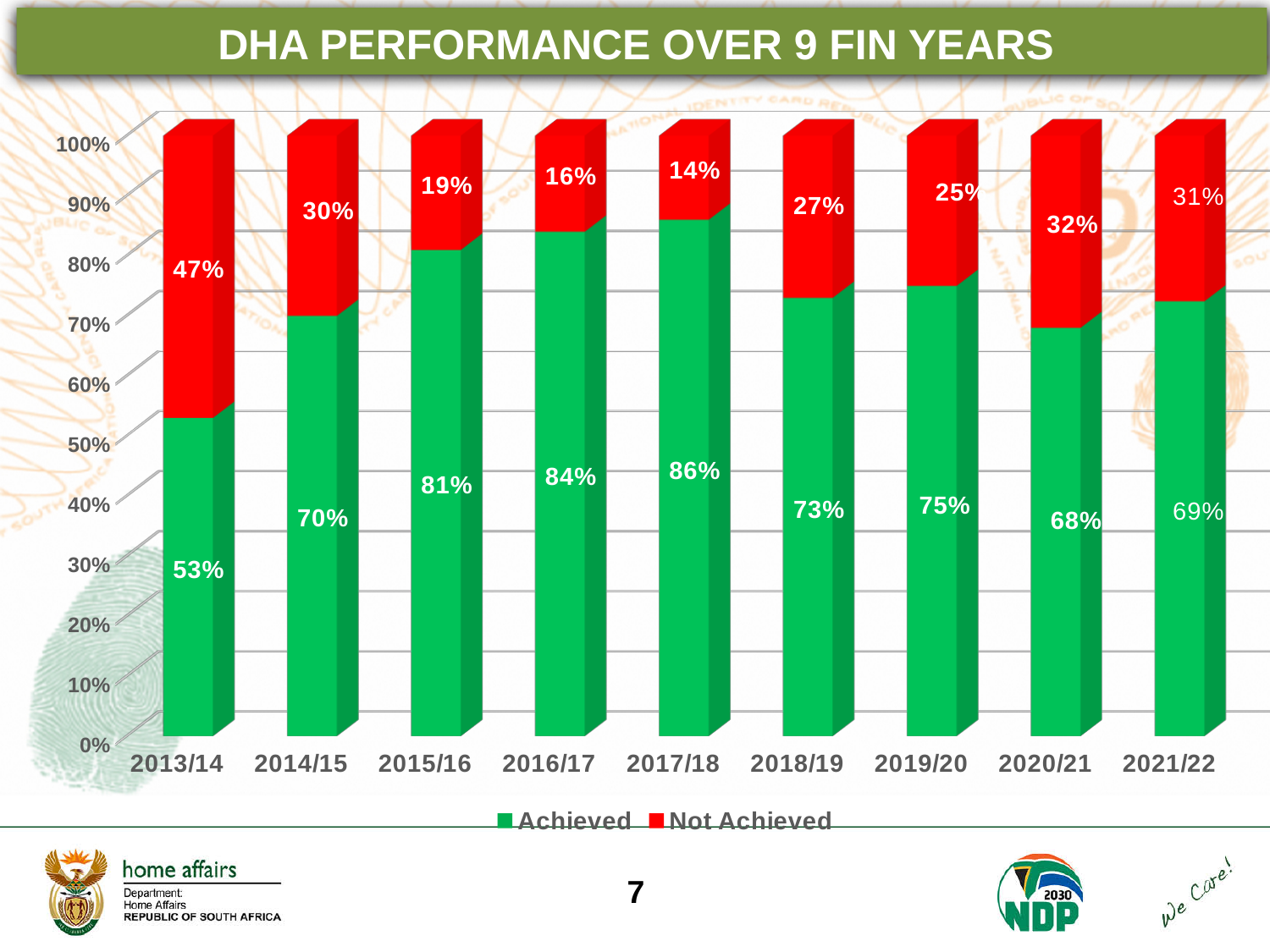
Which colour represents Not Achieved in the legend? Red Which financial year has the lowest Achieved percentage? 2013/14 Which year has a larger Not Achieved value, 2014/15 or 2019/20? 2014/15 What percentage of targets was Achieved in 2017/18? 86% What kind of chart is shown on the slide? Stacked bar chart What is the Achieved value for 2021/22? 69% What is the difference between the Achieved values for 2016/17 and 2020/21? 16% Which financial year has the highest Achieved percentage? 2017/18 How many series does the legend list? 2 How many financial years are shown on the x axis? 9 What is the Not Achieved value for 2013/14? 47% What is the total of the stacked bar for 2018/19? 100%